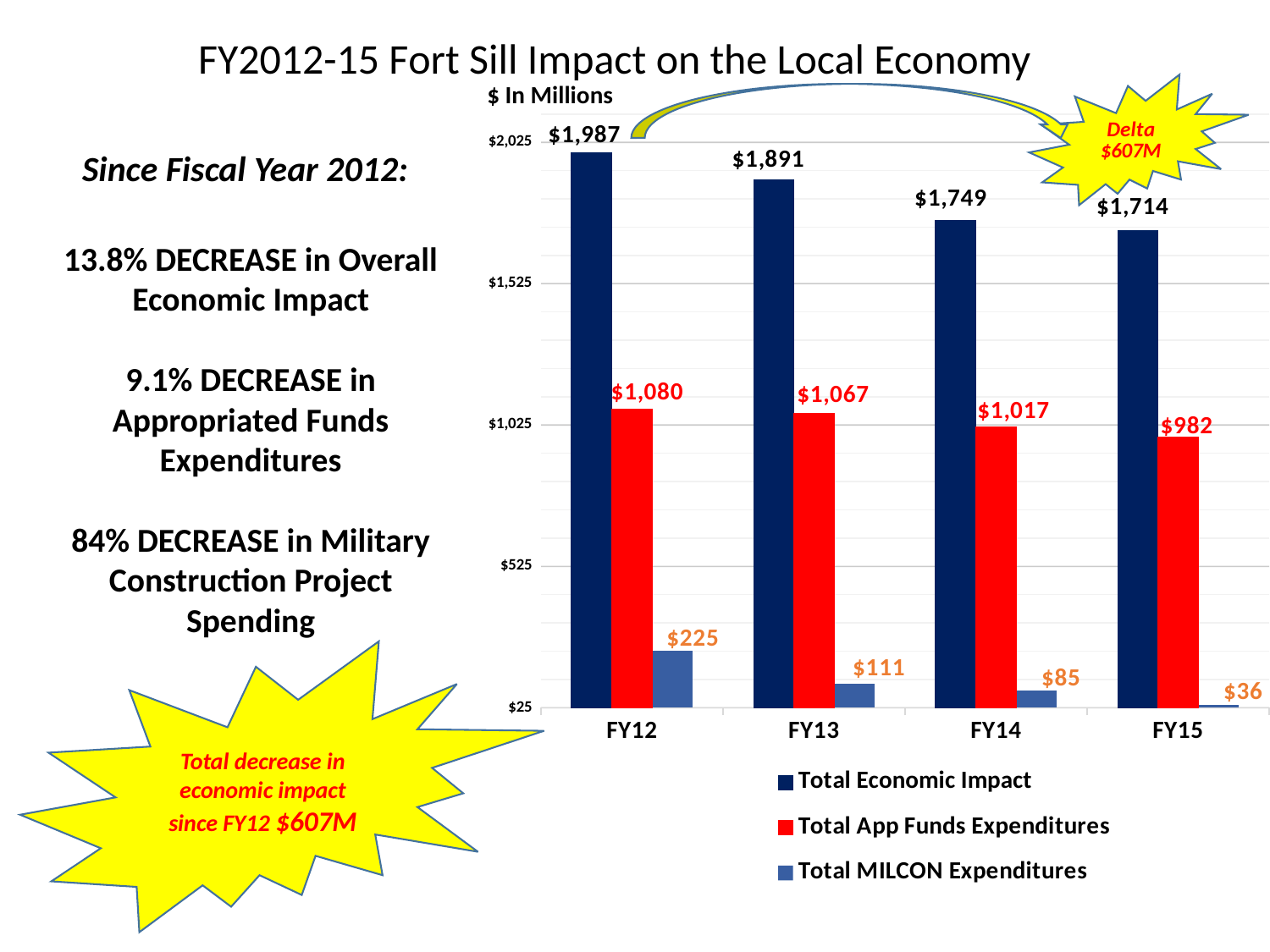
What is the difference between the Total Economic Impact in FY12 and FY15? $273 How many series does the legend list? 3 Is the Total App Funds Expenditures value for FY15 greater or less than $1,025? less What is the Total App Funds Expenditures value for FY14? $1,017 Does the Total Economic Impact rise or fall from FY12 to FY15? fall What is the Total MILCON Expenditures value for FY15? $36 What is the Total Economic Impact value for FY12? $1,987 Which is larger, Total App Funds Expenditures in FY13 or in FY15? FY13 What kind of chart is shown on the slide? bar chart How many fiscal years are shown on the x axis? 4 Which fiscal year has the lowest Total MILCON Expenditures? FY15 Which fiscal year has the highest Total Economic Impact? FY12